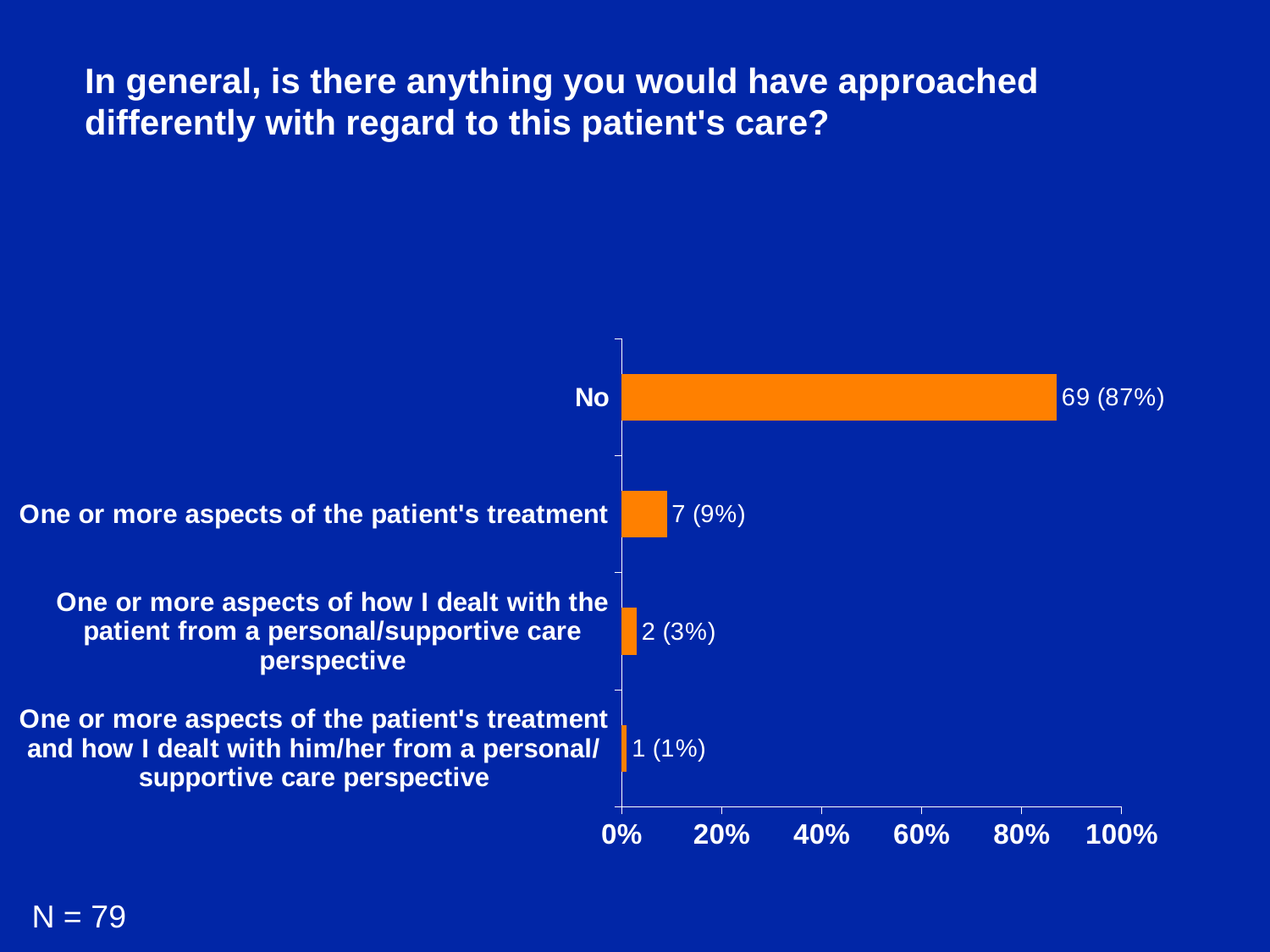
What is the N value shown on the slide? N = 79 How many more respondents answered "No" than "One or more aspects of the patient's treatment"? 62 How many categories are shown in the chart? 4 Which category has the highest value? No What is the data label for "One or more aspects of how I dealt with the patient from a personal/supportive care perspective"? 2 (3%) What is the data label for the "No" bar? 69 (87%) What is the data label for "One or more aspects of the patient's treatment and how I dealt with him/her from a personal/supportive care perspective"? 1 (1%) Is the value for "No" greater or less than 80%? greater What kind of chart is shown on the slide? bar chart What is the data label for "One or more aspects of the patient's treatment"? 7 (9%) Which category has the lowest value? One or more aspects of the patient's treatment and how I dealt with him/her from a personal/supportive care perspective Which is larger: the value for "One or more aspects of the patient's treatment" or the value for "One or more aspects of how I dealt with the patient from a personal/supportive care perspective"? One or more aspects of the patient's treatment